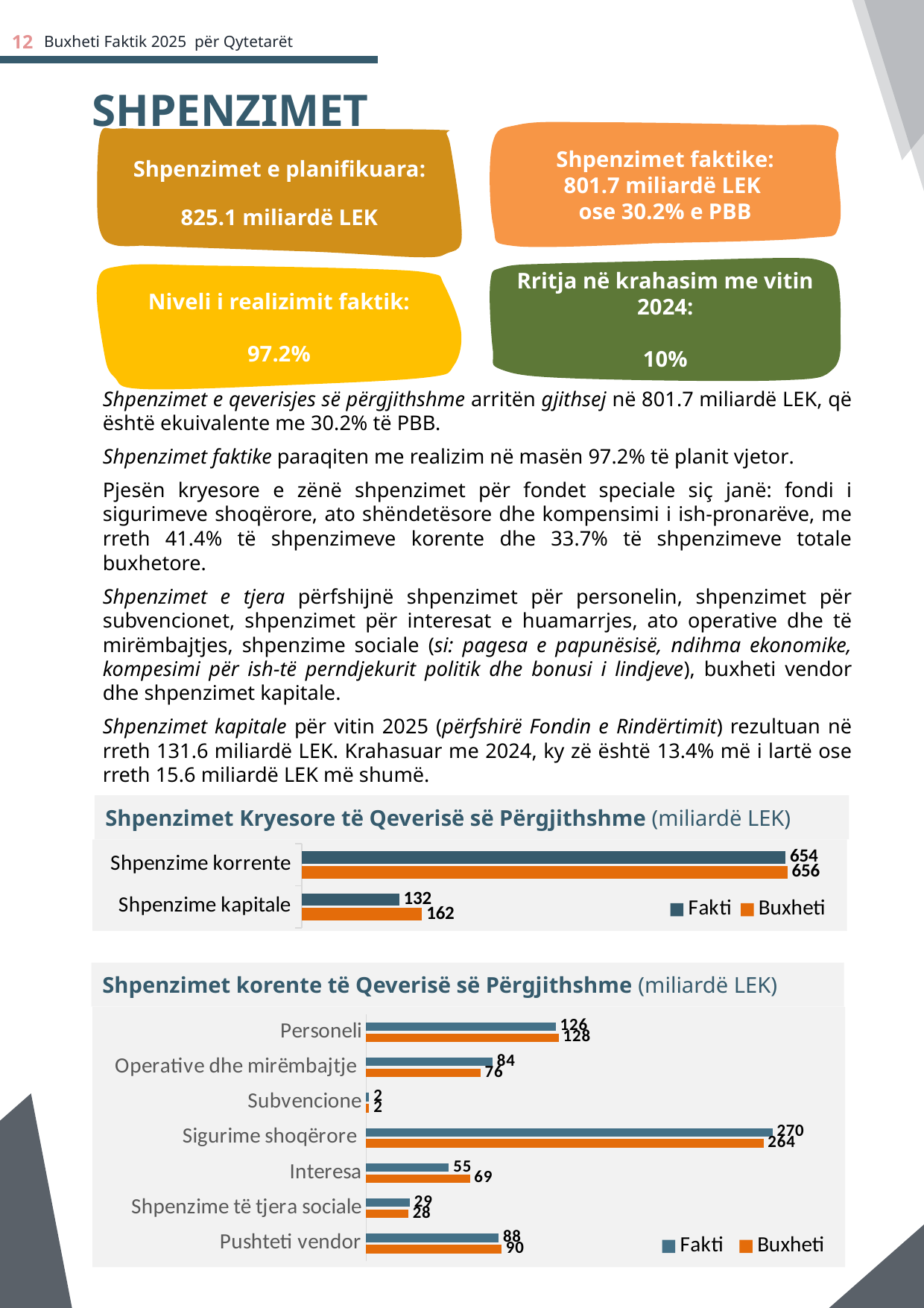
In the chart 'Shpenzimet Kryesore të Qeverisë së Përgjithshme', how many series does the legend list? 2 In the chart 'Shpenzimet Kryesore të Qeverisë së Përgjithshme', what is the difference between the Buxheti and Fakti values for Shpenzime kapitale? 30 In the chart 'Shpenzimet korente të Qeverisë së Përgjithshme', what is the difference between the Buxheti and Fakti values for Interesa? 14 In the chart 'Shpenzimet korente të Qeverisë së Përgjithshme', which category has the highest Fakti value? Sigurime shoqërore In the chart 'Shpenzimet Kryesore të Qeverisë së Përgjithshme', what is the Fakti value for Shpenzime korrente? 654 In the chart 'Shpenzimet korente të Qeverisë së Përgjithshme', how many categories are shown? 7 In the chart 'Shpenzimet korente të Qeverisë së Përgjithshme', which is larger for Operative dhe mirëmbajtje: Fakti or Buxheti? Fakti In the chart 'Shpenzimet korente të Qeverisë së Përgjithshme', which category has the lowest Buxheti value? Subvencione In the chart 'Shpenzimet Kryesore të Qeverisë së Përgjithshme', what is the Buxheti value for Shpenzime kapitale? 162 In the chart 'Shpenzimet korente të Qeverisë së Përgjithshme', what is the Buxheti value for Interesa? 69 What kind of chart is 'Shpenzimet Kryesore të Qeverisë së Përgjithshme'? Bar chart In the chart 'Shpenzimet korente të Qeverisë së Përgjithshme', what is the Fakti value for Sigurime shoqërore? 270